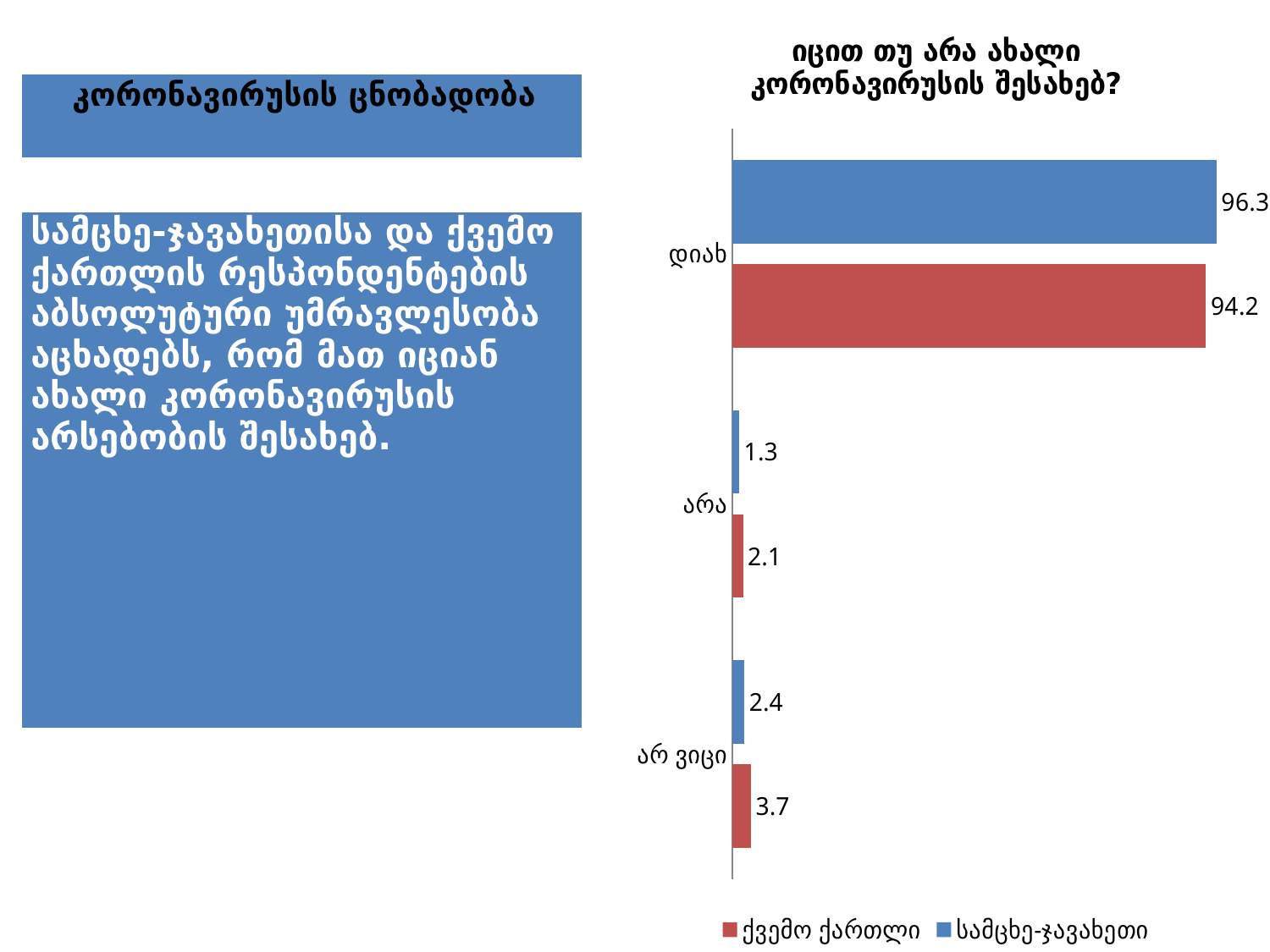
What is the value for სამცხე-ჯავახეთი in the არა category? 1.3 What is the difference between the სამცხე-ჯავახეთი and ქვემო ქართლი values in the დიახ category? 2.1 How many categories are shown on the chart? 3 What type of chart is shown on the slide? bar chart What is the value for ქვემო ქართლი in the დიახ category? 94.2 What is the value for სამცხე-ჯავახეთი in the დიახ category? 96.3 What is the value for ქვემო ქართლი in the არ ვიცი category? 3.7 How many series does the legend list? 2 What colour are the bars for ქვემო ქართლი? red Which category has the lowest value for სამცხე-ჯავახეთი? არა In the არ ვიცი category, which series has the larger value, ქვემო ქართლი or სამცხე-ჯავახეთი? ქვემო ქართლი Which category has the highest value for ქვემო ქართლი? დიახ